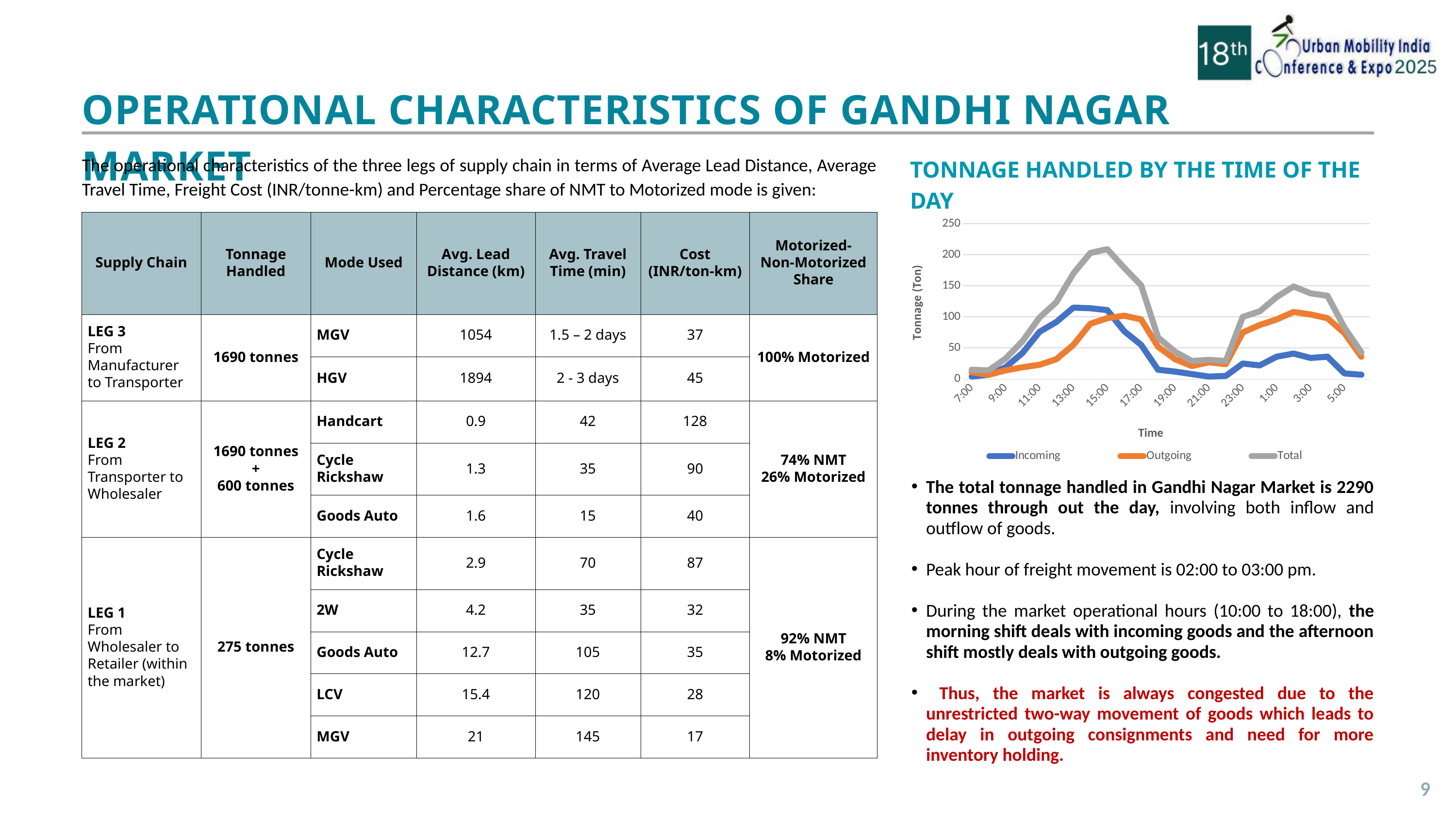
In the tonnage chart, at 3:00, which is larger: Incoming or Outgoing? Outgoing In the tonnage chart, does the Total line rise or fall between 7:00 and 15:00? rise In the tonnage chart, is the Incoming value at 13:00 greater or less than 100? greater What kind of chart is shown under the title 'TONNAGE HANDLED BY THE TIME OF THE DAY'? line chart What is the label on the vertical axis of the tonnage chart? Tonnage (Ton) In the tonnage chart, is the Outgoing value at 11:00 greater or less than 50? less What are the three series named in the legend of the tonnage chart? Incoming, Outgoing, Total How many series does the legend of the tonnage chart list? 3 In the tonnage chart, is the Incoming value at 19:00 greater or less than 50? less In the tonnage chart, at 13:00, which is larger: Incoming or Outgoing? Incoming How many time labels are shown along the x axis of the tonnage chart? 12